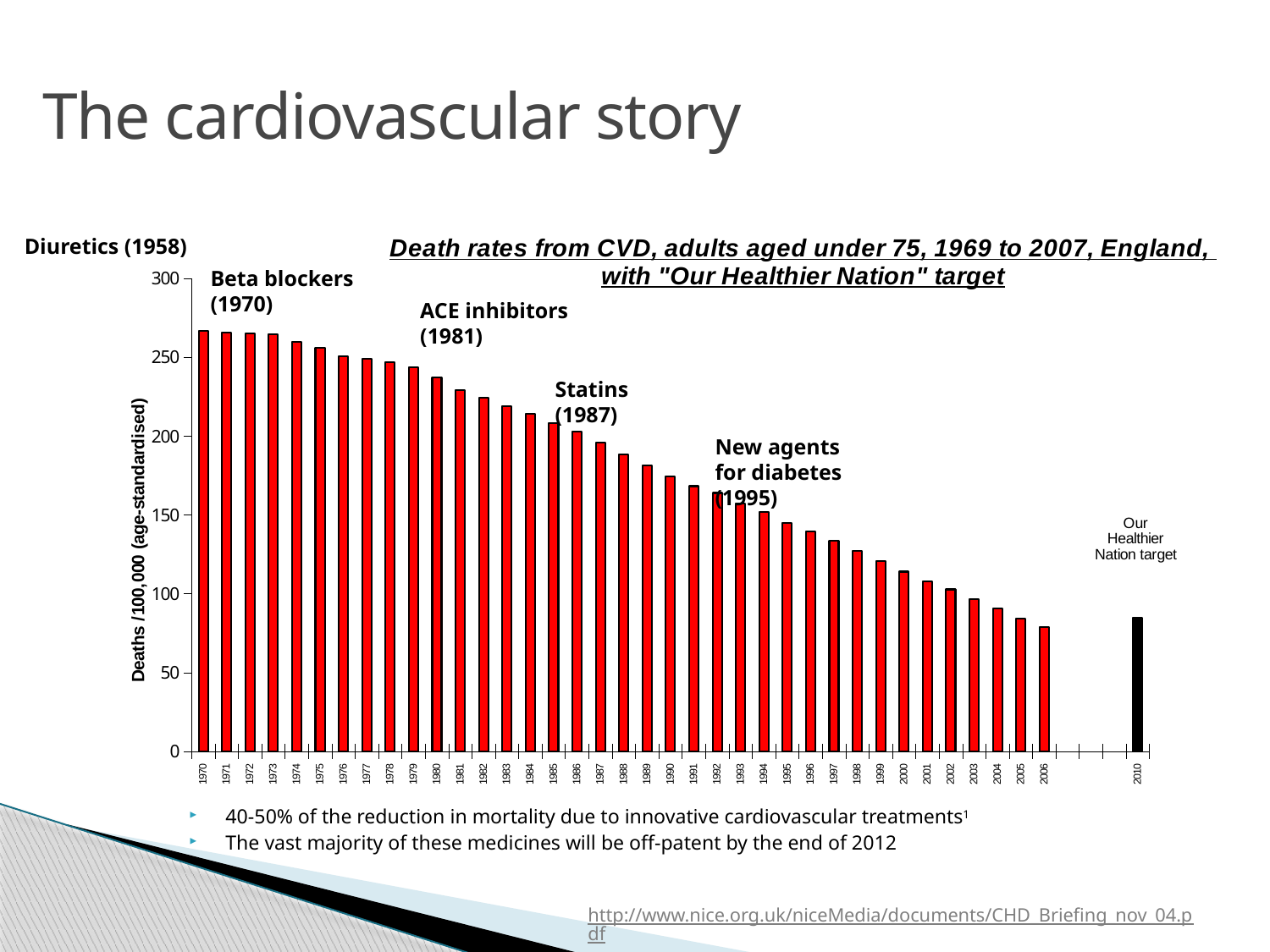
Which year has the highest death rate in the chart? 1970 Is the death rate for 1990 greater or less than 150? greater Which year has the higher death rate, 1975 or 1995? 1975 Do the death rates rise or fall from 1970 to 2006? fall Is the death rate for 1970 greater or less than 250? greater Is the Our Healthier Nation target bar for 2010 greater or less than 100? less What kind of chart is shown on the slide? bar chart What is the title of the chart? Death rates from CVD, adults aged under 75, 1969 to 2007, England, with "Our Healthier Nation" target Among the years 1970 to 2006, which year has the lowest death rate? 2006 What is the label on the vertical axis of the chart? Deaths /100,000 (age-standardised)